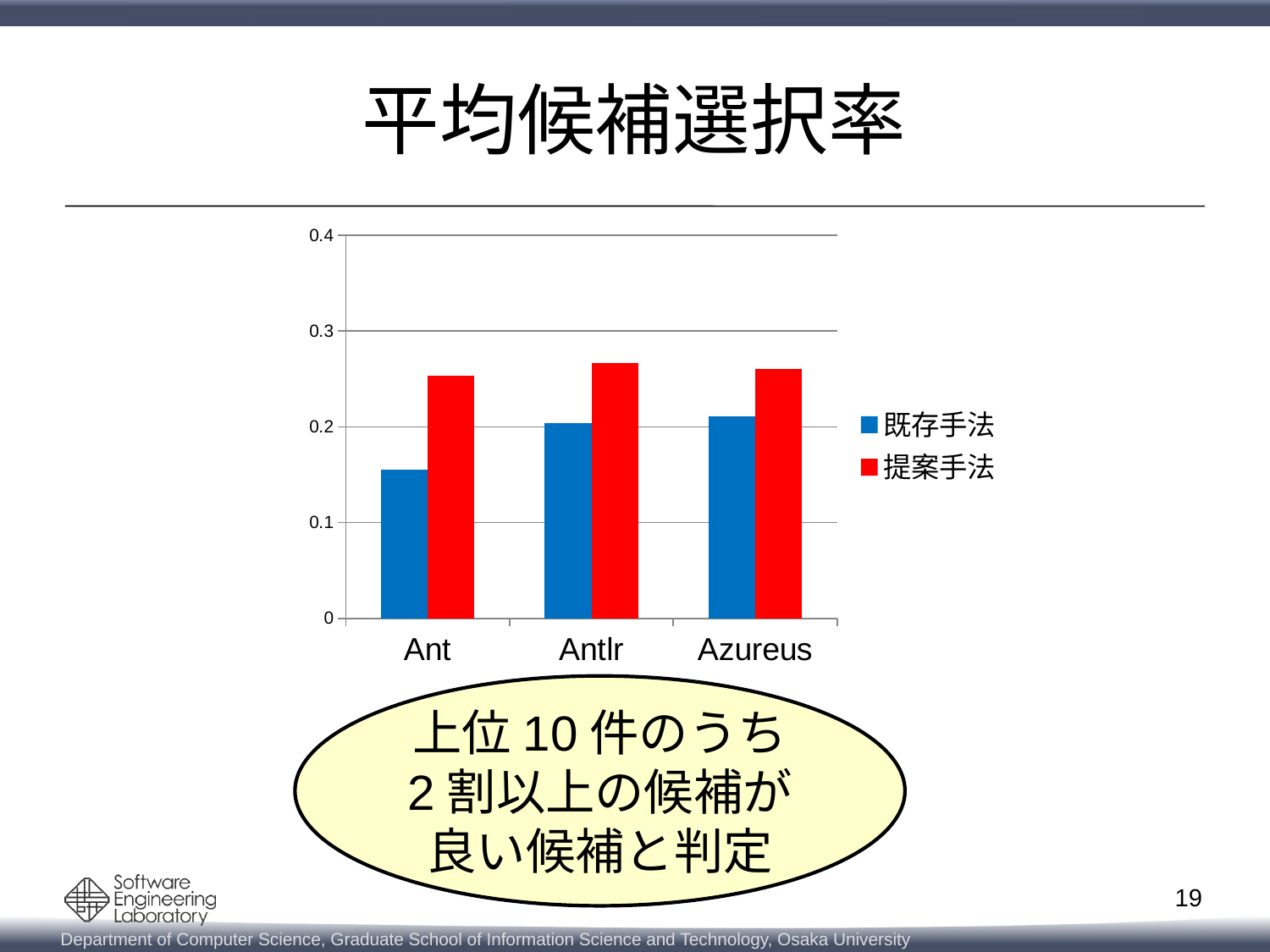
For Ant, which series has the larger value, 既存手法 or 提案手法? 提案手法 Which category has the lowest value for 既存手法? Ant Is the value of 提案手法 for Azureus greater or less than 0.2? greater How many categories are shown on the x axis of the chart? 3 Which series is drawn in red in the chart? 提案手法 Is the value of 提案手法 for Ant greater or less than 0.2? greater Is the value of 提案手法 for Antlr greater or less than 0.3? less What is the title of the chart on the slide? 平均候補選択率 For Azureus, which series has the larger value, 既存手法 or 提案手法? 提案手法 How many series does the chart's legend list? 2 What kind of chart is shown on the slide? bar chart